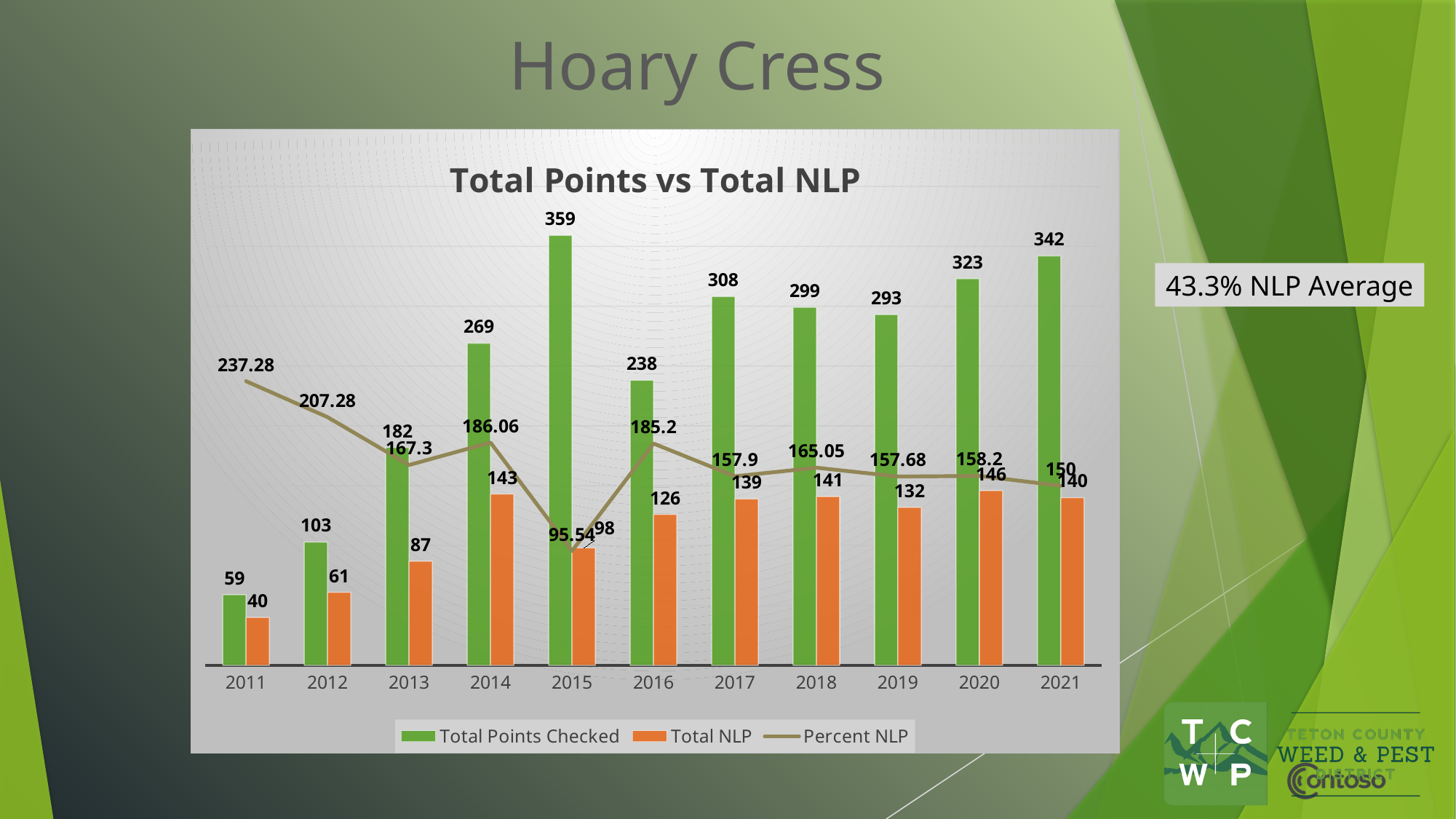
What is the Percent NLP value for 2011? 237.28 What is the Total NLP value for 2014? 143 What is the Total Points Checked value for 2015? 359 Does the Percent NLP line generally rise or fall from 2011 to 2021? Fall Which year has the highest Total Points Checked? 2015 What kind of chart is used for the Total Points Checked and Total NLP series? Bar chart Which is larger, Total NLP in 2018 or Total NLP in 2019? 2018 Which year has the lowest Total NLP? 2011 How many series does the legend list? 3 What is the difference between Total Points Checked and Total NLP in 2021? 202 What is the title of the chart? Total Points vs Total NLP How many years are shown on the x axis? 11